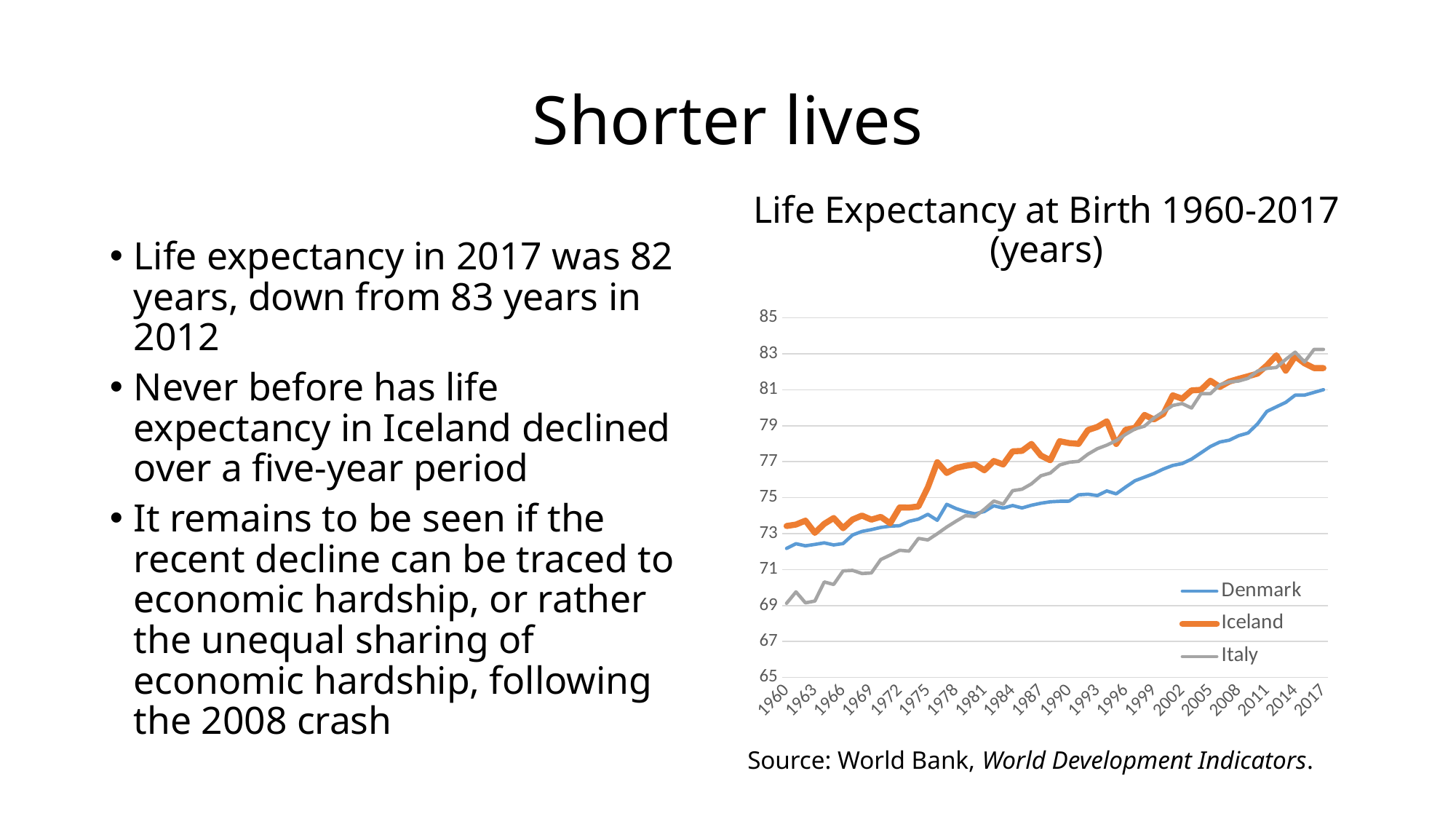
Which country had the highest life expectancy in 1960? Iceland In 1990, which was higher: life expectancy in Iceland or in Denmark? Iceland Which country had the lowest life expectancy in 2017? Denmark In 2017, which was higher: life expectancy in Italy or in Iceland? Italy Which colour is used for the Iceland line in the chart? Orange Does life expectancy in Denmark generally rise or fall from 1960 to 2017? Rise Is the value for Denmark in 2017 greater or less than 79? greater Which country had the lowest life expectancy in 1960? Italy What is the title of the chart? Life Expectancy at Birth 1960-2017 (years) Is the value for Italy in 1960 greater or less than 71? less How many series does the chart's legend list? 3 What kind of chart is shown on the slide? Line chart